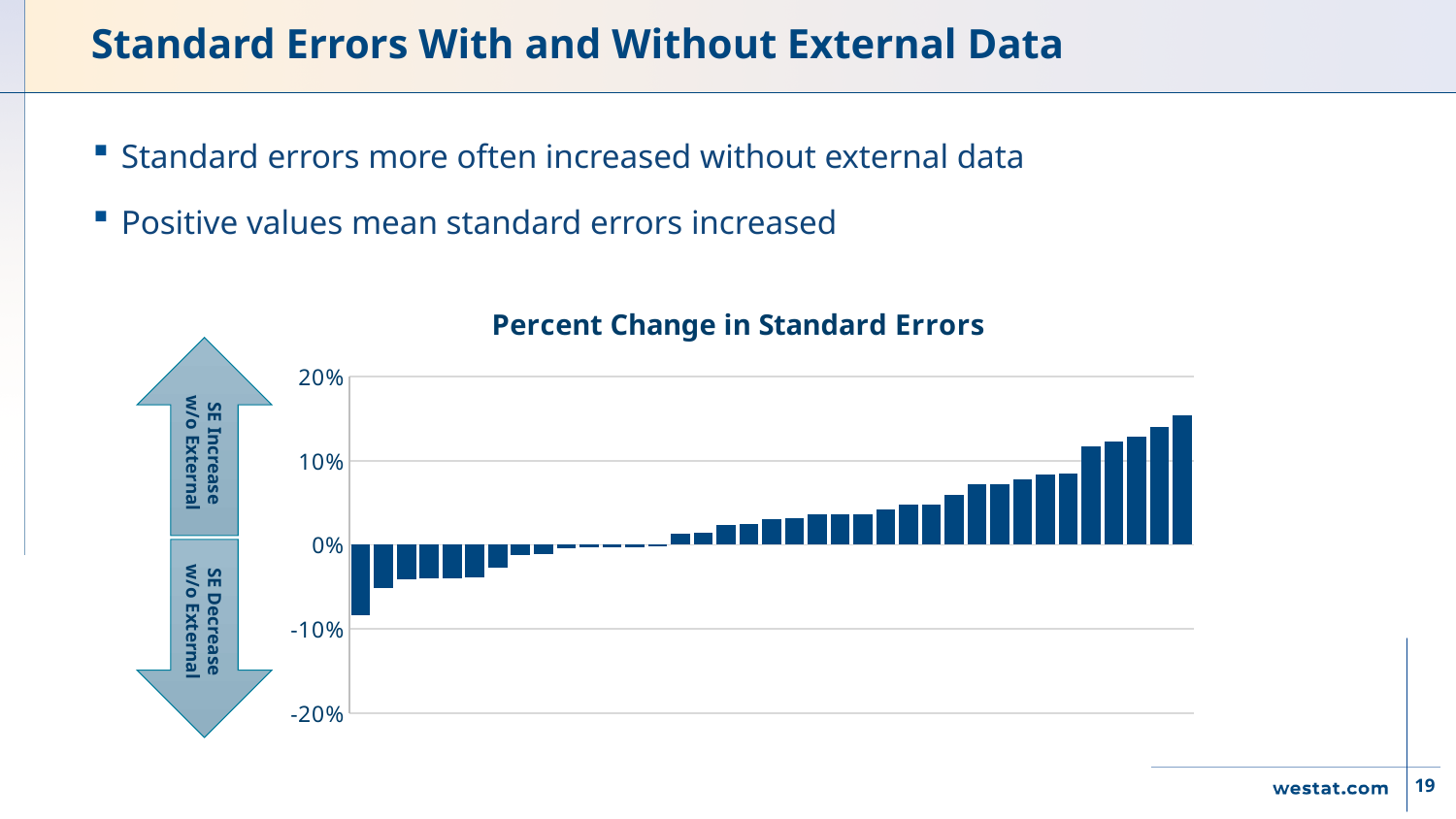
What is the title of the chart? Percent Change in Standard Errors Is the value of the leftmost bar greater or less than 0%? less Which bar has the highest value, the leftmost or the rightmost? rightmost Is the value of the rightmost bar greater or less than 20%? less Are there more bars with positive values or more bars with negative values? positive What kind of chart is shown on the slide? bar chart Is the value of the rightmost bar greater or less than 10%? greater What are the minimum and maximum values shown on the vertical axis? -20% and 20% Which bar has the lowest value, the leftmost or the rightmost? leftmost Do the bar values rise or fall moving from left to right along the x axis? rise